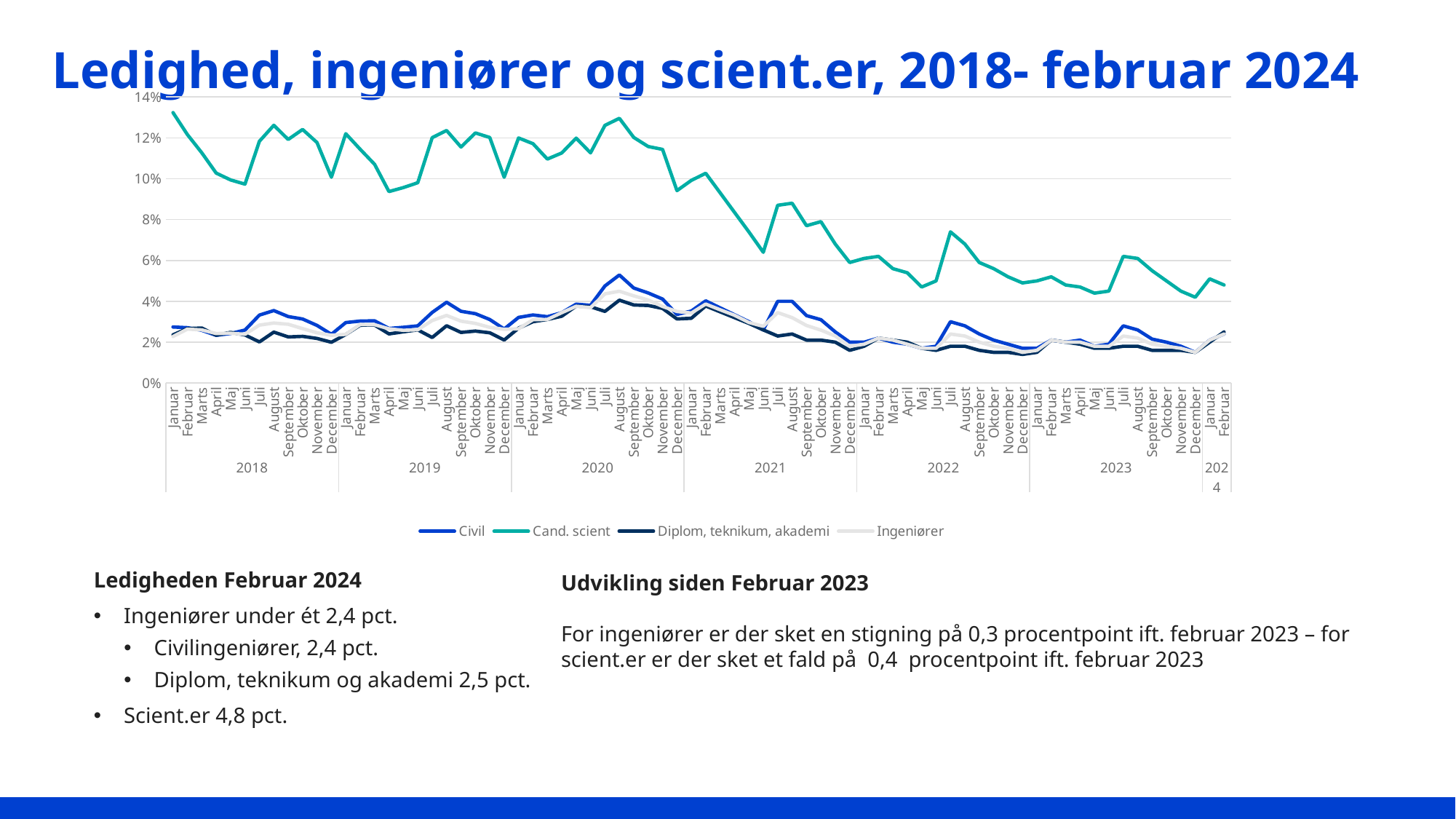
What kind of chart is shown on the slide? line chart According to the slide, what is the unemployment rate for Scient.er in February 2024? 4,8 pct. According to the slide, what is the unemployment rate for Diplom, teknikum og akademi in February 2024? 2,5 pct. What is the title of the slide containing the chart? Ledighed, ingeniører og scient.er, 2018- februar 2024 How many series does the chart legend list? 4 In January 2018, which is larger: the value for Cand. scient or the value for Civil? Cand. scient Is the value for Civil in August 2020 greater or less than 4%? greater Is the value for Cand. scient in December 2023 greater or less than 6%? less Does the Cand. scient line generally rise or fall from 2018 to February 2024? fall Is the value for Cand. scient in January 2018 greater or less than 12%? greater Which series has the highest unemployment rate throughout the chart? Cand. scient